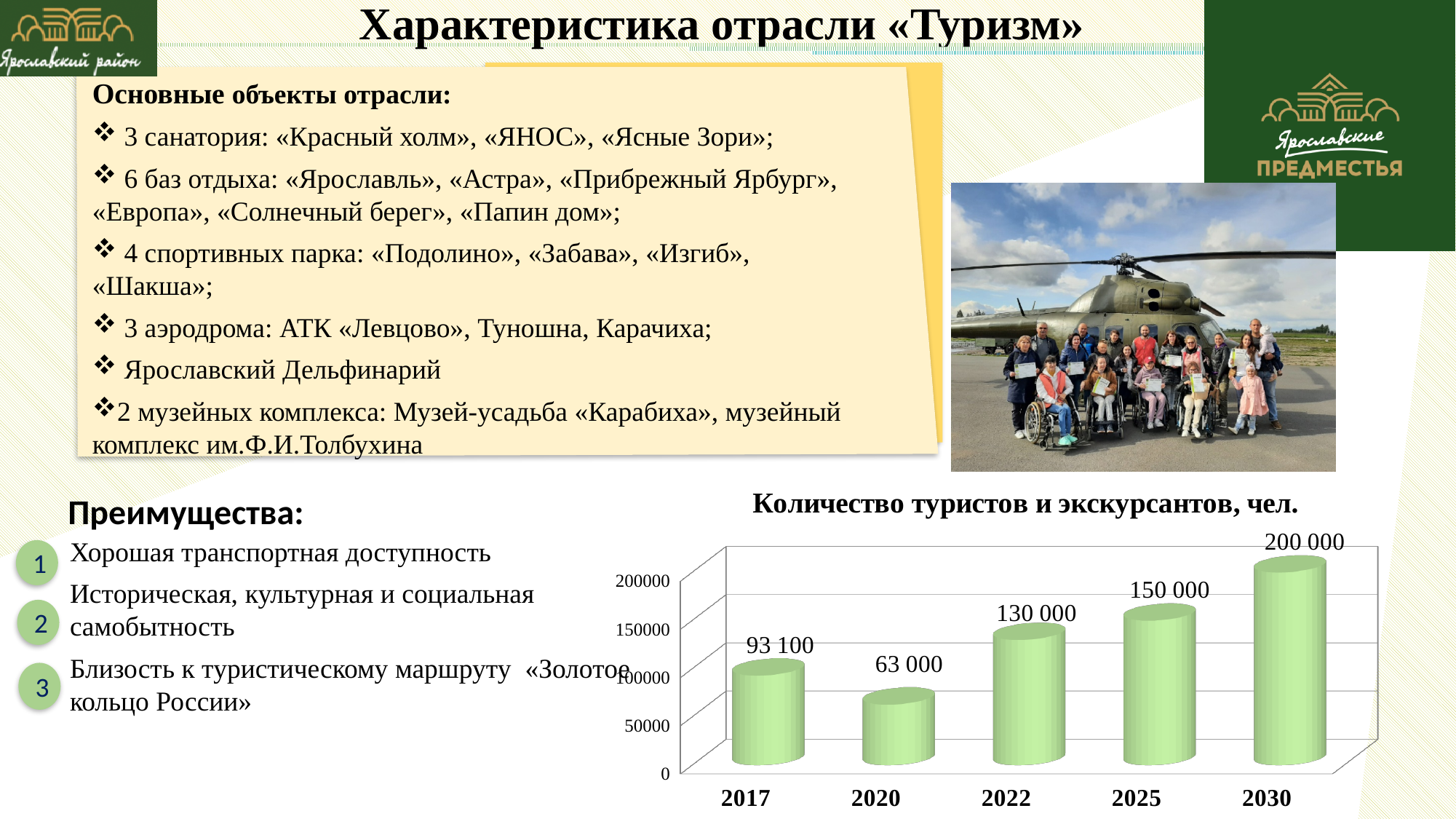
What kind of chart is 'Количество туристов и экскурсантов, чел.'? bar chart In the chart 'Количество туристов и экскурсантов, чел.', what is the difference between the values for 2017 and 2020? 30 100 What is the value for 2022 in the chart 'Количество туристов и экскурсантов, чел.'? 130 000 What is the value for 2017 in the chart 'Количество туристов и экскурсантов, чел.'? 93 100 How many years are shown on the x axis of the chart 'Количество туристов и экскурсантов, чел.'? 5 Which year has the lowest value in the chart 'Количество туристов и экскурсантов, чел.'? 2020 What is the value for 2030 in the chart 'Количество туристов и экскурсантов, чел.'? 200 000 In the chart 'Количество туристов и экскурсантов, чел.', which is larger: the value for 2017 or the value for 2020? 2017 In the chart 'Количество туристов и экскурсантов, чел.', what is the difference between the values for 2030 and 2025? 50 000 Which year has the highest value in the chart 'Количество туристов и экскурсантов, чел.'? 2030 In the chart 'Количество туристов и экскурсантов, чел.', is the value for 2022 greater or less than 100000? greater What is the value for 2020 in the chart 'Количество туристов и экскурсантов, чел.'? 63 000